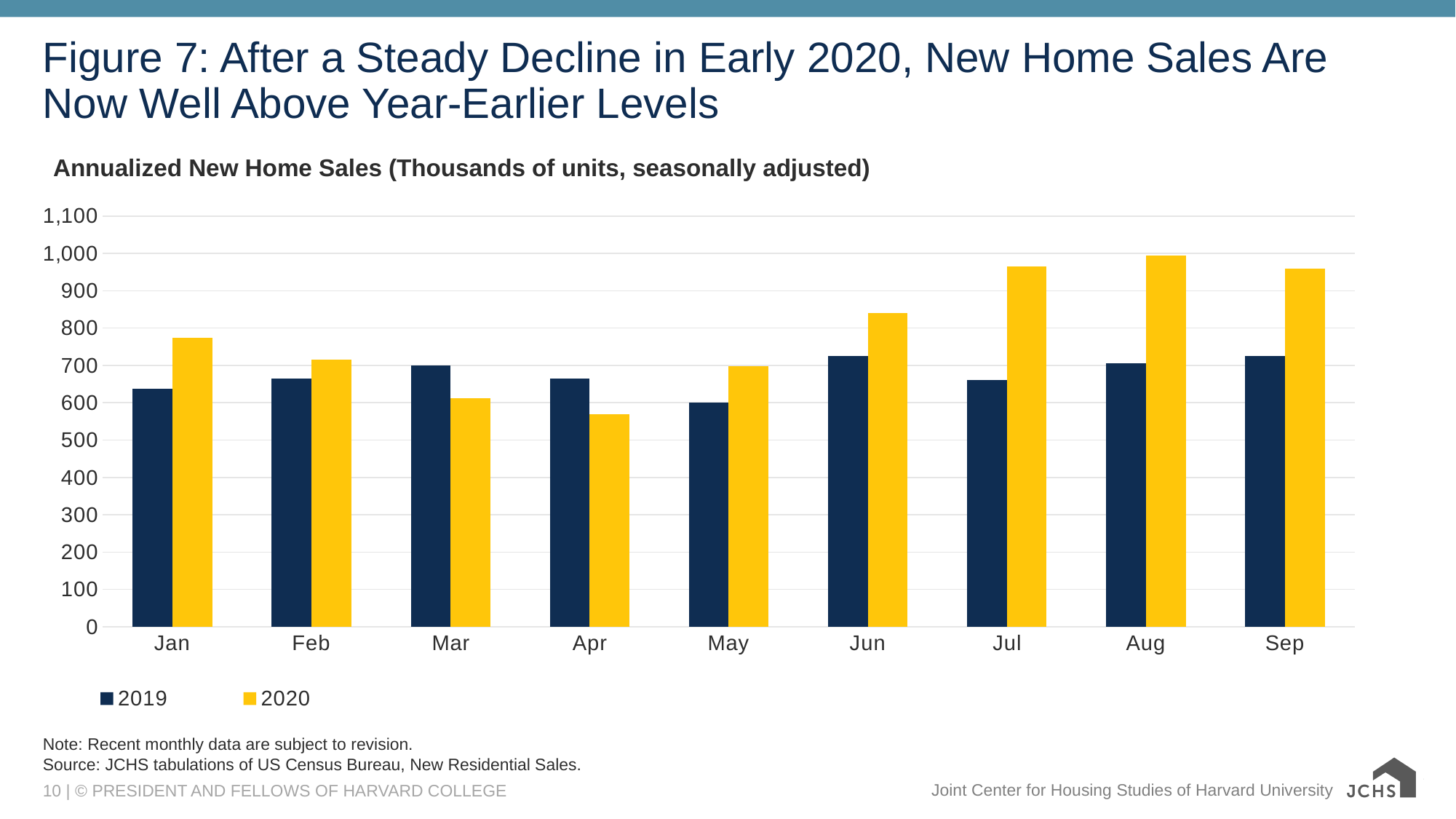
Is the 2019 value for Jan greater or less than 700? less Is the 2020 value for Jul greater or less than 900? greater What kind of chart is shown on the slide? Bar chart How many series does the legend list? 2 For Mar, which series has the larger value, 2019 or 2020? 2019 In which month is the 2020 value highest? Aug In which month is the 2020 value lowest? Apr Is the 2020 value for Apr greater or less than 600? less In which month is the 2019 value lowest? May How many months are shown on the x axis? 9 For Jan, which series has the larger value, 2019 or 2020? 2020 Do the 2020 values rise or fall from Apr to Aug? rise